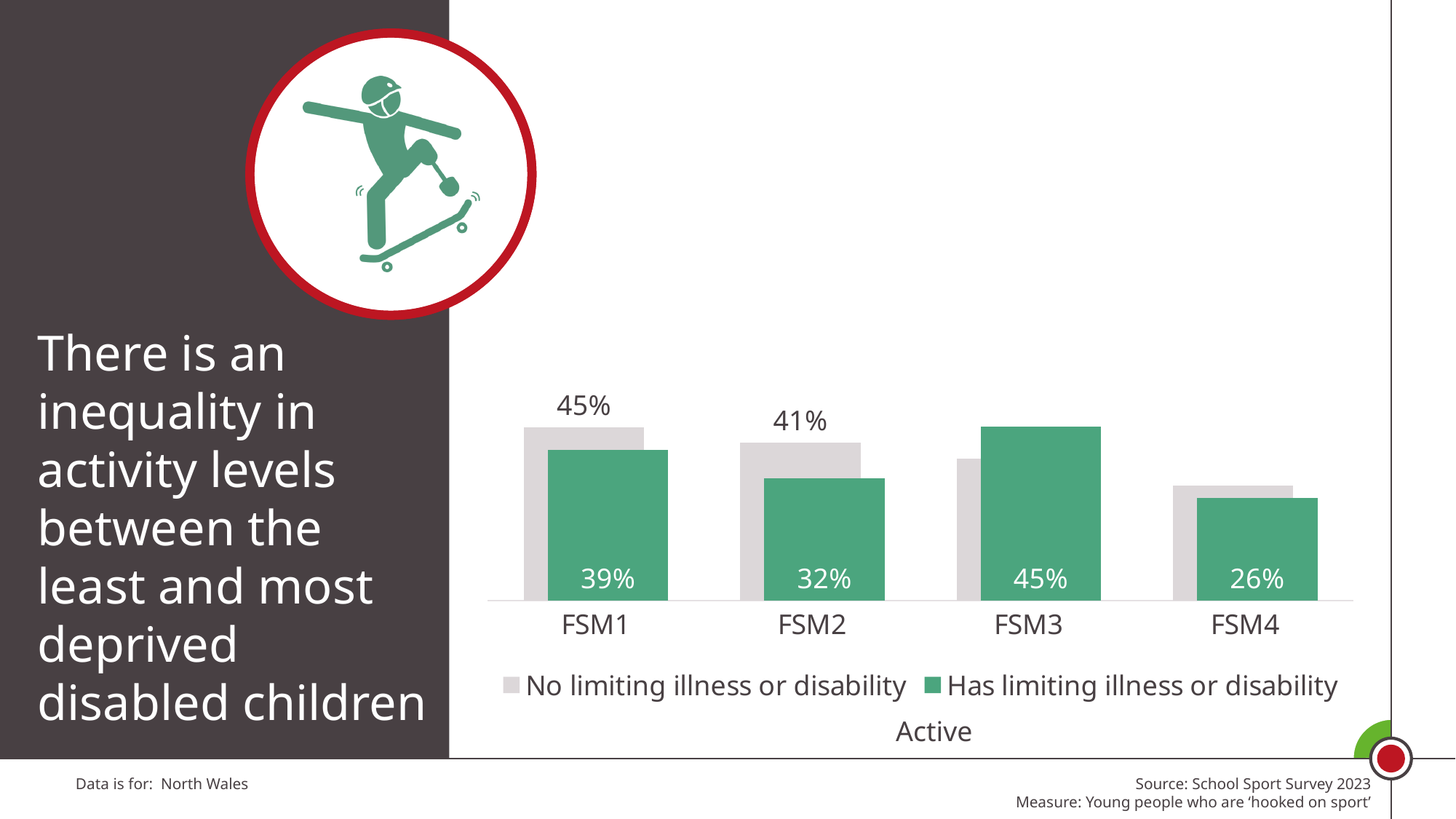
What is the value for FSM4 in the 'Has limiting illness or disability' series? 26% How many series does the chart legend list? 2 What is the difference between the 'No limiting illness or disability' and 'Has limiting illness or disability' values for FSM2? 9% Which category has the highest value in the 'Has limiting illness or disability' series? FSM3 What is the value for FSM1 in the 'No limiting illness or disability' series? 45% Which category has the lowest value in the 'Has limiting illness or disability' series? FSM4 What kind of chart is shown on the slide? Bar chart What is the difference between the 'Has limiting illness or disability' values for FSM3 and FSM4? 19% What is the value for FSM1 in the 'Has limiting illness or disability' series? 39% What is the value for FSM2 in the 'No limiting illness or disability' series? 41% For FSM3, which series has the larger value: 'No limiting illness or disability' or 'Has limiting illness or disability'? Has limiting illness or disability How many categories are shown on the x axis of the chart? 4